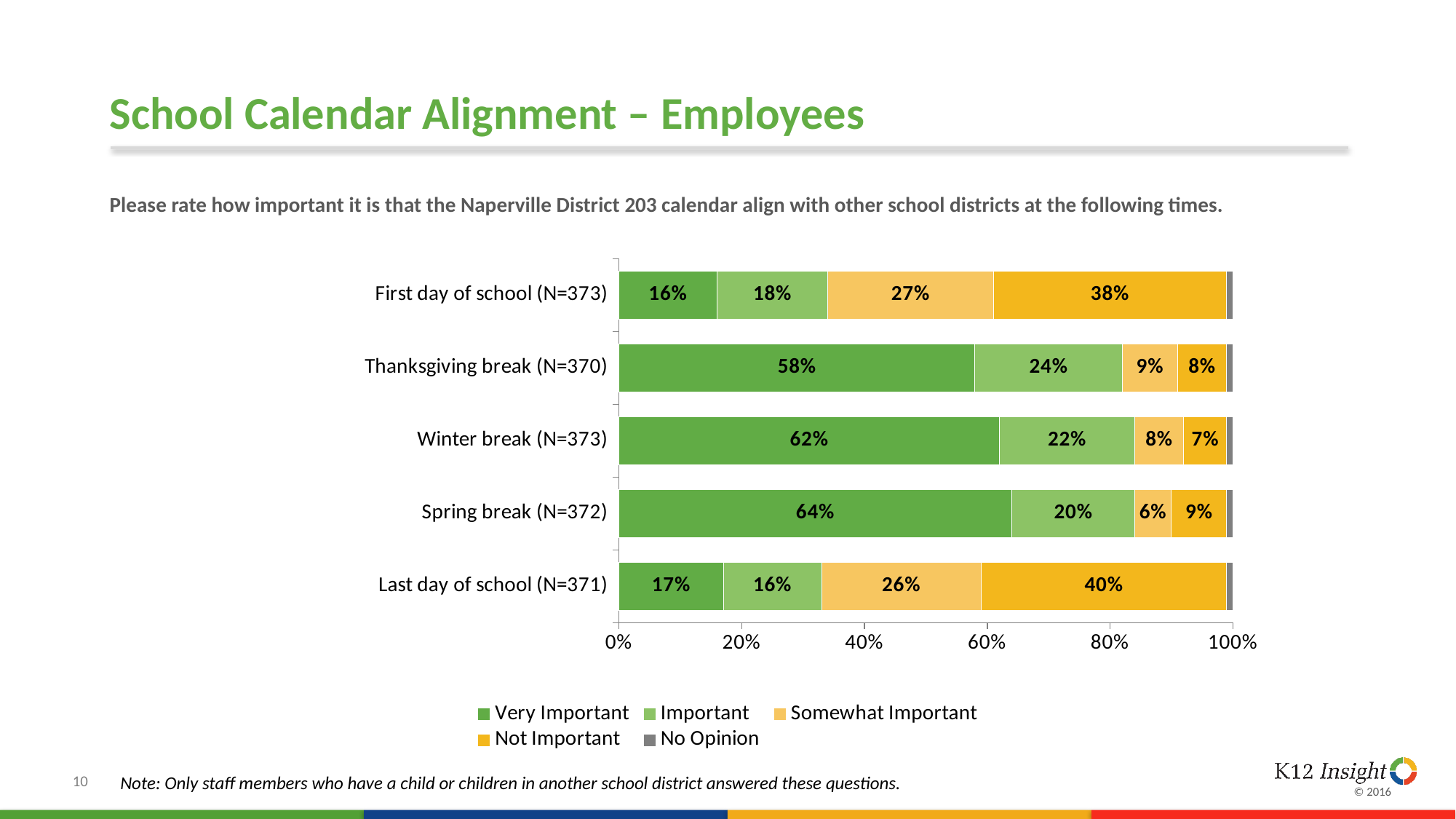
What percentage of employees rated aligning the calendar for the Last day of school (N=371) as Somewhat Important? 26% What percentage of employees rated aligning the calendar for the First day of school (N=373) as Not Important? 38% Which category has the lowest Very Important percentage? First day of school (N=373) Which legend entry is shown in grey? No Opinion What percentage of employees rated aligning the calendar for Thanksgiving break (N=370) as Important? 24% Which category has the highest Very Important percentage? Spring break (N=372) What is the difference between the Not Important percentages for Last day of school (N=371) and First day of school (N=373)? 2% How many categories are shown on the chart? 5 How many series does the legend list? 5 What percentage of employees rated aligning the calendar for Spring break (N=372) as Very Important? 64% What kind of chart is shown on the slide? Stacked bar chart Which has a larger Very Important percentage, Winter break (N=373) or Thanksgiving break (N=370)? Winter break (N=373)